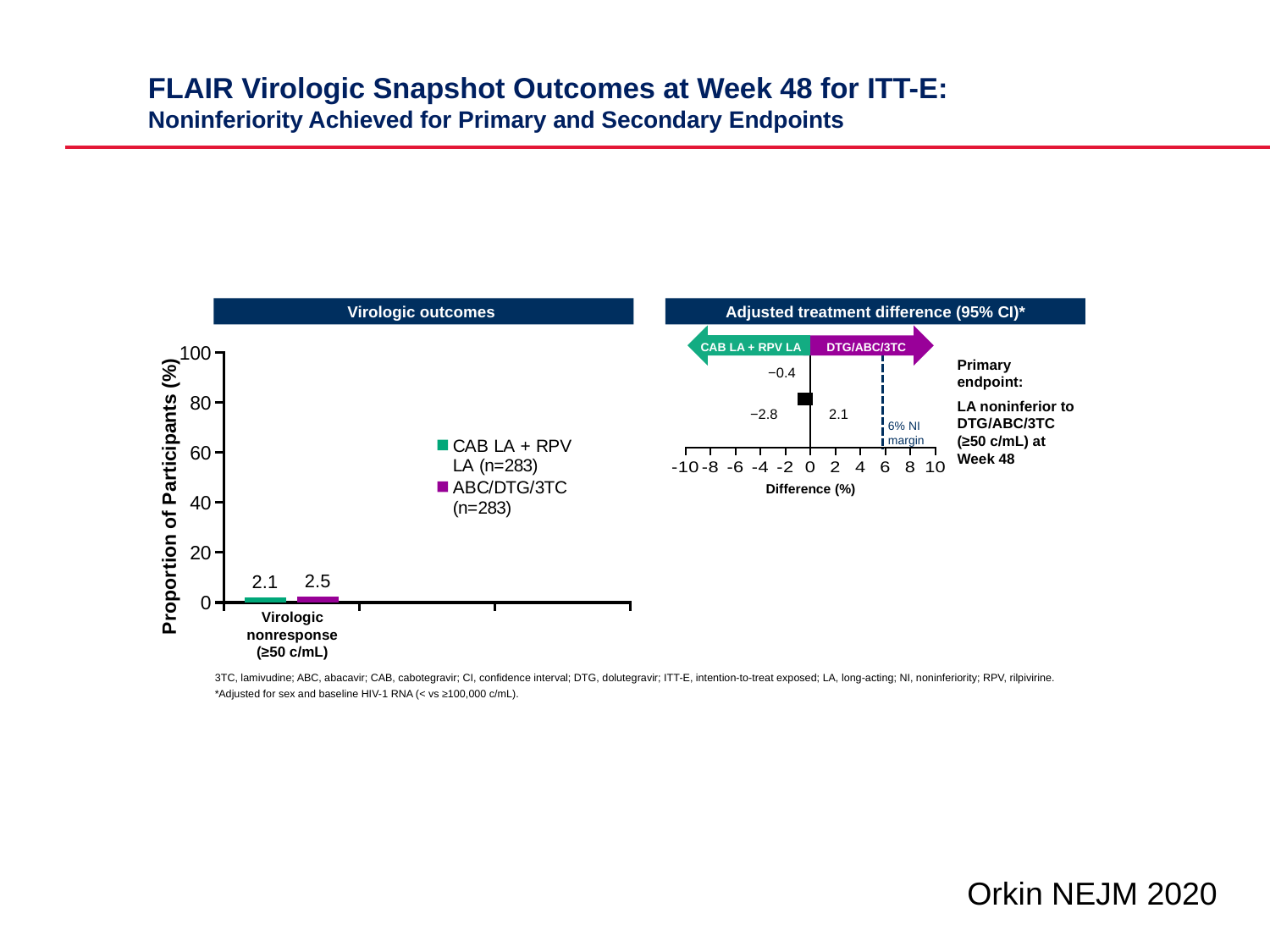
In the Adjusted treatment difference chart, what is the upper bound of the 95% CI? 2.1 In the Virologic outcomes chart, which series has the higher value for Virologic nonresponse (≥50 c/mL)? ABC/DTG/3TC In the Virologic outcomes chart, what is the value for CAB LA + RPV LA for Virologic nonresponse (≥50 c/mL)? 2.1 What is the y-axis label of the Virologic outcomes chart? Proportion of Participants (%) In the Virologic outcomes chart, what is the difference between the ABC/DTG/3TC and CAB LA + RPV LA values for Virologic nonresponse? 0.4 In the Virologic outcomes chart, is the value for CAB LA + RPV LA greater or less than 20? less In the Adjusted treatment difference chart, what is the lower bound of the 95% CI? −2.8 In the Adjusted treatment difference chart, what is the noninferiority margin shown by the dashed line? 6% NI margin In the Virologic outcomes chart, what is the value for ABC/DTG/3TC for Virologic nonresponse (≥50 c/mL)? 2.5 How many series does the legend of the Virologic outcomes chart list? 2 What kind of chart is the Virologic outcomes chart? bar chart In the Adjusted treatment difference chart, what is the point estimate of the adjusted treatment difference? −0.4